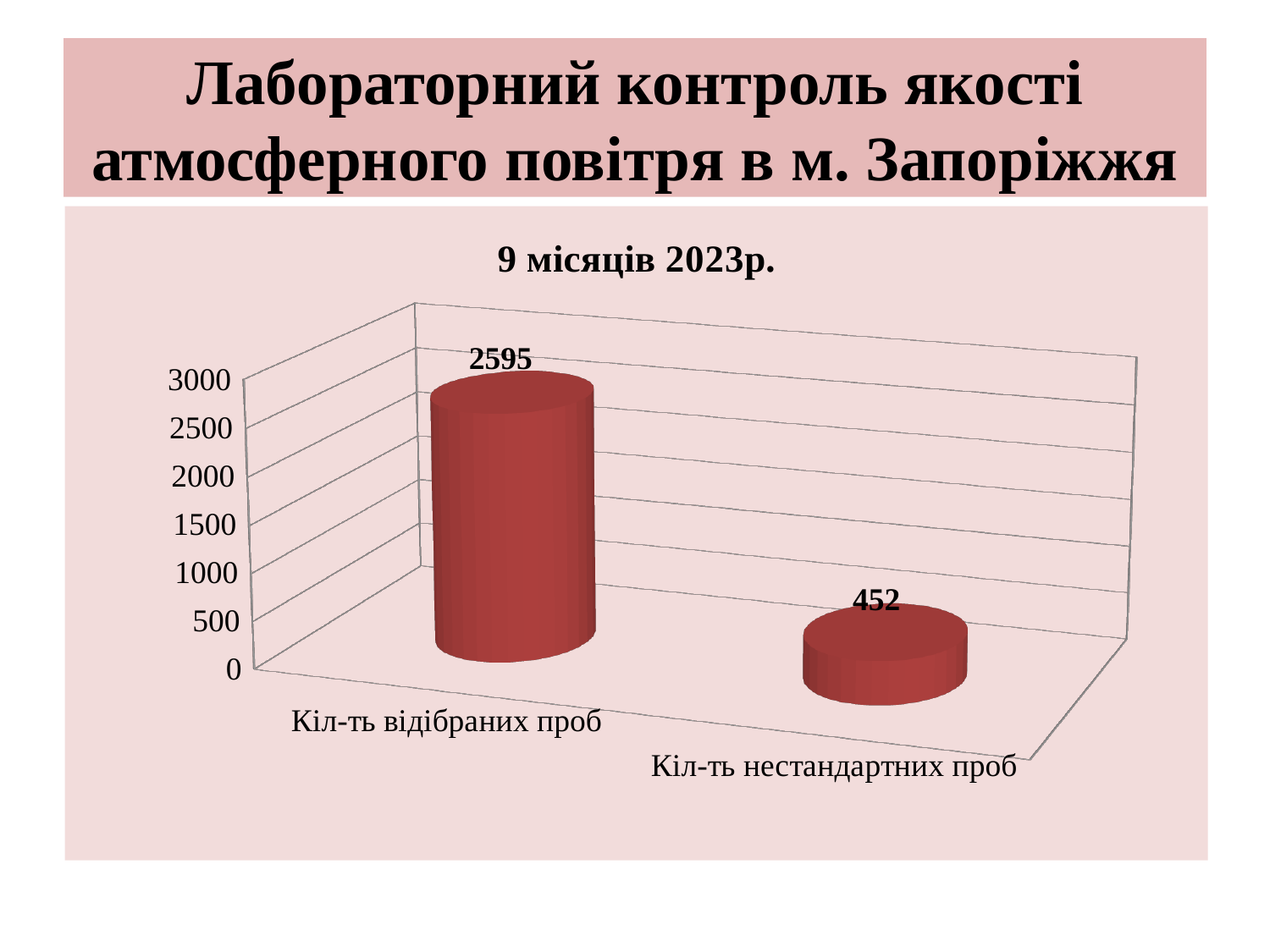
What is the difference between the values for "Кіл-ть відібраних проб" and "Кіл-ть нестандартних проб"? 2143 How many categories are shown in the chart? 2 What is the value for "Кіл-ть відібраних проб"? 2595 What is the value for "Кіл-ть нестандартних проб"? 452 Which is larger: the value for "Кіл-ть відібраних проб" or for "Кіл-ть нестандартних проб"? Кіл-ть відібраних проб Is the value for "Кіл-ть нестандартних проб" greater or less than 500? less Which category has the lowest value? Кіл-ть нестандартних проб Which category has the highest value? Кіл-ть відібраних проб What is the highest value shown on the vertical axis? 3000 What kind of chart is shown on the slide? bar chart What is the title of the chart? 9 місяців 2023р. Is the value for "Кіл-ть відібраних проб" greater or less than 2500? greater